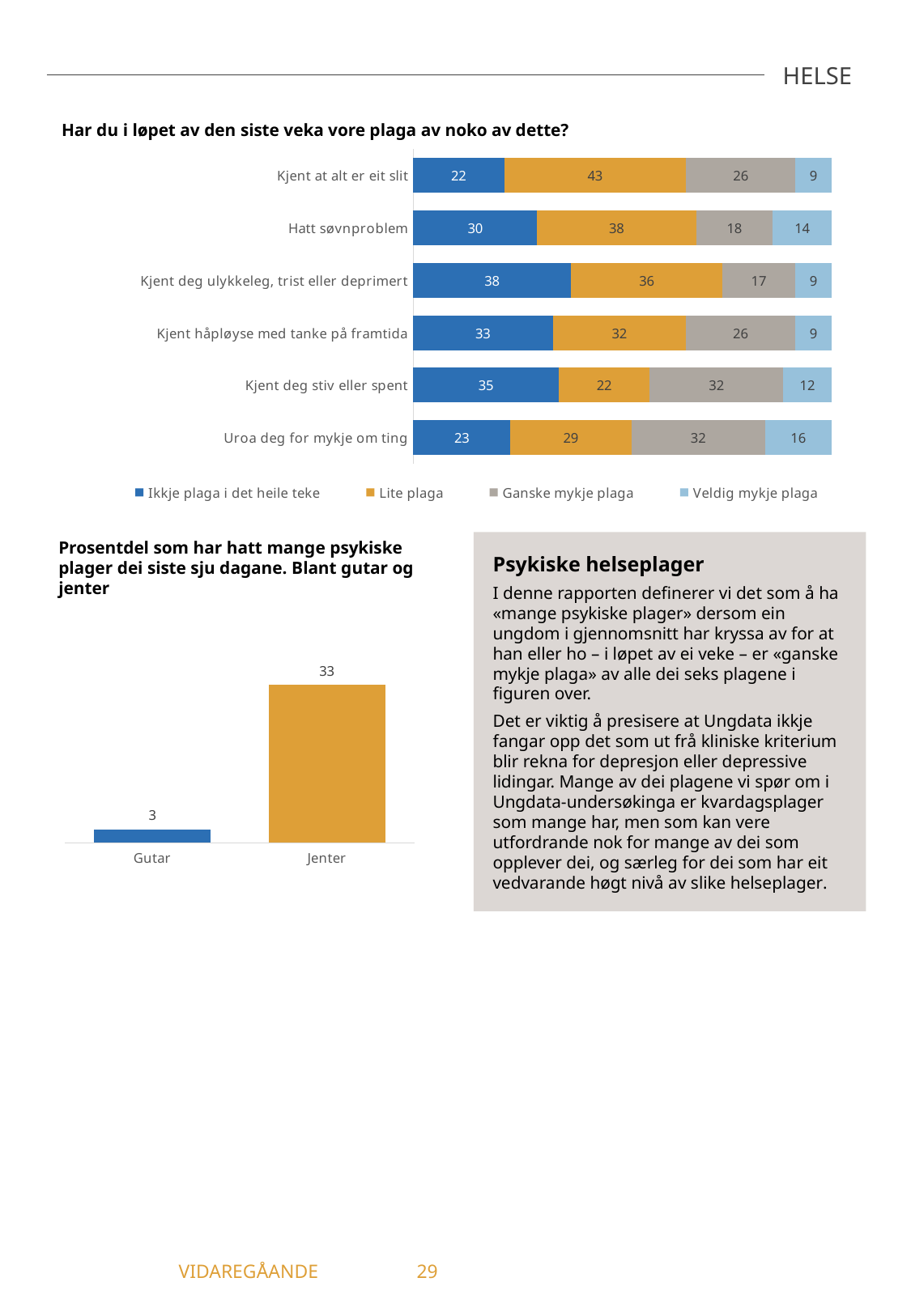
In the chart 'Prosentdel som har hatt mange psykiske plager dei siste sju dagane', what is the difference between the values for 'Jenter' and 'Gutar'? 30 In the chart 'Har du i løpet av den siste veka vore plaga av noko av dette?', what is the value for 'Veldig mykje plaga' for 'Uroa deg for mykje om ting'? 16 In the chart 'Har du i løpet av den siste veka vore plaga av noko av dette?', what is the value for 'Lite plaga' for 'Kjent at alt er eit slit'? 43 In the chart 'Har du i løpet av den siste veka vore plaga av noko av dette?', which category has the lowest value for 'Lite plaga'? Kjent deg stiv eller spent What kind of chart is 'Har du i løpet av den siste veka vore plaga av noko av dette?'? Stacked bar chart In the chart 'Har du i løpet av den siste veka vore plaga av noko av dette?', which legend entry is shown in dark blue? Ikkje plaga i det heile teke In the chart 'Har du i løpet av den siste veka vore plaga av noko av dette?', what is the difference between the 'Ganske mykje plaga' values for 'Kjent deg stiv eller spent' and 'Hatt søvnproblem'? 14 In the chart 'Prosentdel som har hatt mange psykiske plager dei siste sju dagane', what is the value for 'Jenter'? 33 In the chart 'Har du i løpet av den siste veka vore plaga av noko av dette?', which category has the highest value for 'Ikkje plaga i det heile teke'? Kjent deg ulykkeleg, trist eller deprimert How many categories are shown in the chart 'Har du i løpet av den siste veka vore plaga av noko av dette?'? 6 How many series does the legend list in the chart 'Har du i løpet av den siste veka vore plaga av noko av dette?'? 4 In the chart 'Har du i løpet av den siste veka vore plaga av noko av dette?', which is larger: the 'Veldig mykje plaga' value for 'Hatt søvnproblem' or for 'Kjent deg stiv eller spent'? Hatt søvnproblem